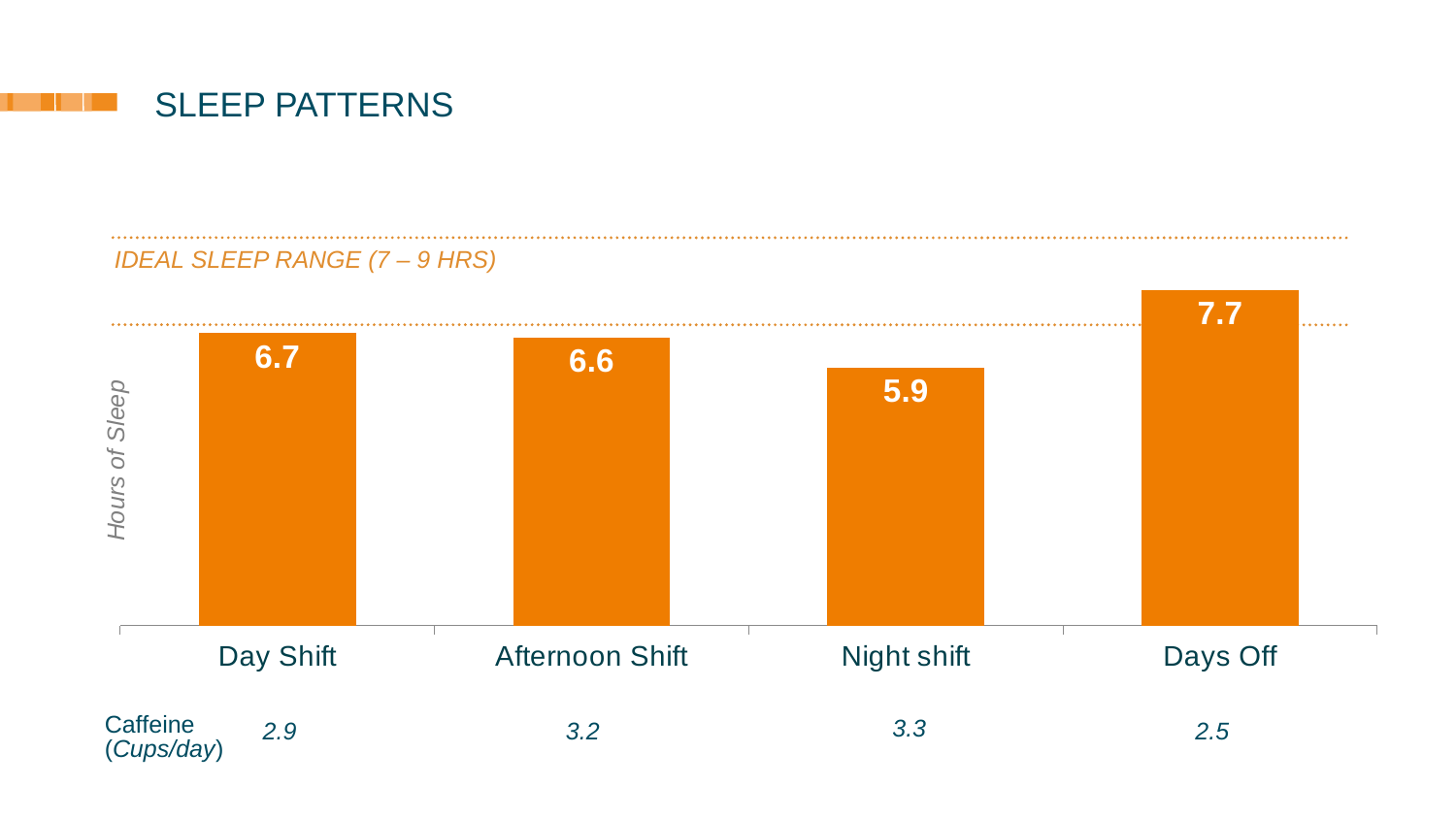
What is the value for Days Off? 7.7 What is the difference between the values for Days Off and Night shift? 1.8 What is the value for Day Shift? 6.7 Which is larger, the value for Day Shift or the value for Night shift? Day Shift What is the difference between the values for Day Shift and Afternoon Shift? 0.1 How many categories are shown on the chart? 4 Which category has the lowest hours of sleep? Night shift What kind of chart is shown on the slide? Bar chart Which category has the highest hours of sleep? Days Off What is the value for Night shift? 5.9 What is the title of the slide? SLEEP PATTERNS What is the value for Afternoon Shift? 6.6